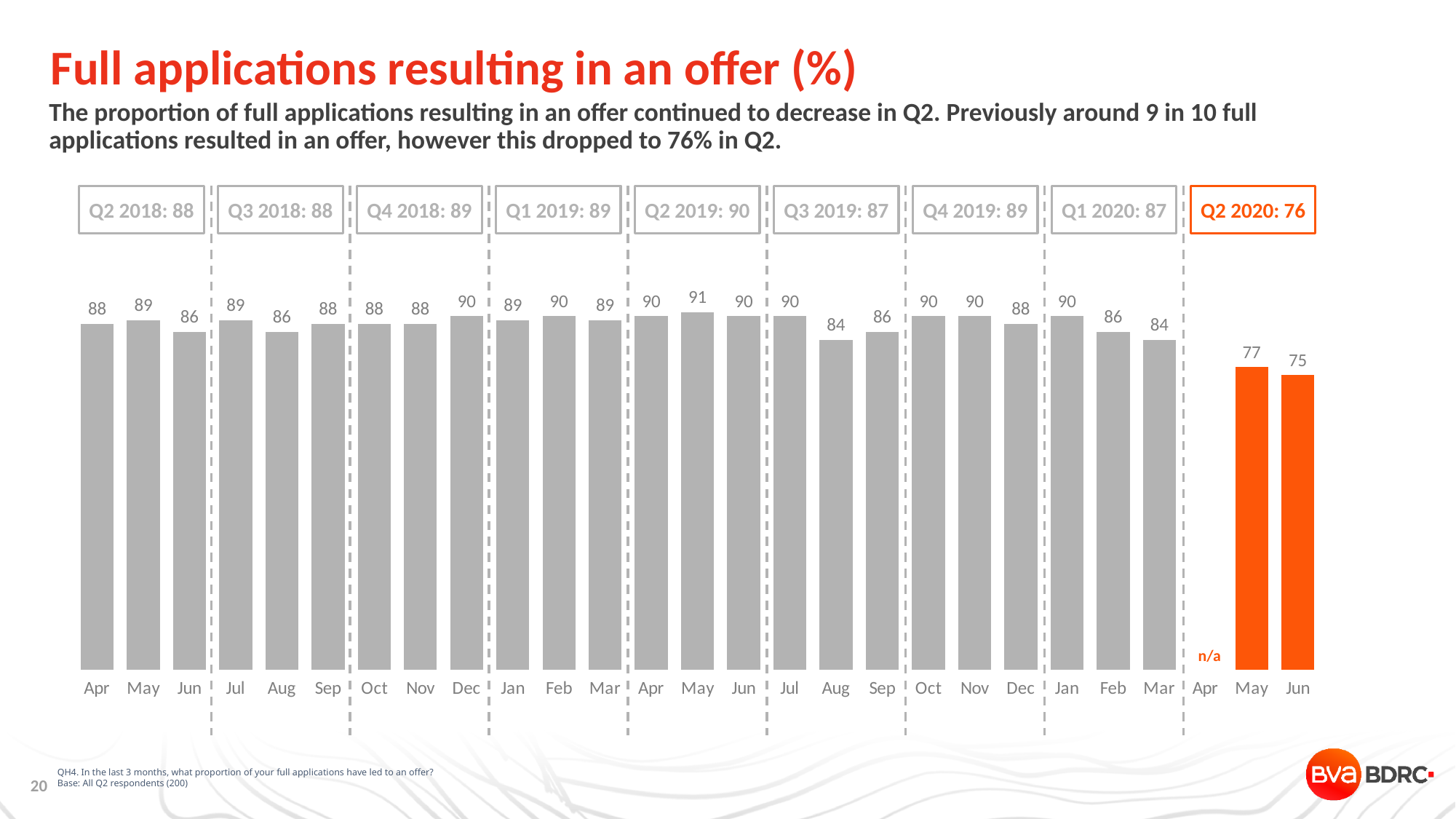
Which is larger: the Dec bar in the Q4 2018 section or the Dec bar in the Q4 2019 section? Dec in Q4 2018 (90) What is shown for the Apr bar in the Q2 2020 section? n/a What value is shown in the box for Q2 2020? 76 What is the value for the May bar in the Q2 2019 section? 91 What kind of chart is shown on the slide? Bar chart What is the value for the Aug bar in the Q3 2019 section? 84 Which month has the highest bar on the chart? May (Q2 2019) Which month has the lowest bar on the chart? Jun (Q2 2020) What is the value for the May 2020 bar (in the Q2 2020 section)? 77 What is the value for the June 2020 bar (in the Q2 2020 section)? 75 What value is shown in the box for Q2 2019? 90 What is the difference between the Mar bar in the Q1 2020 section and the May bar in the Q2 2020 section? 7